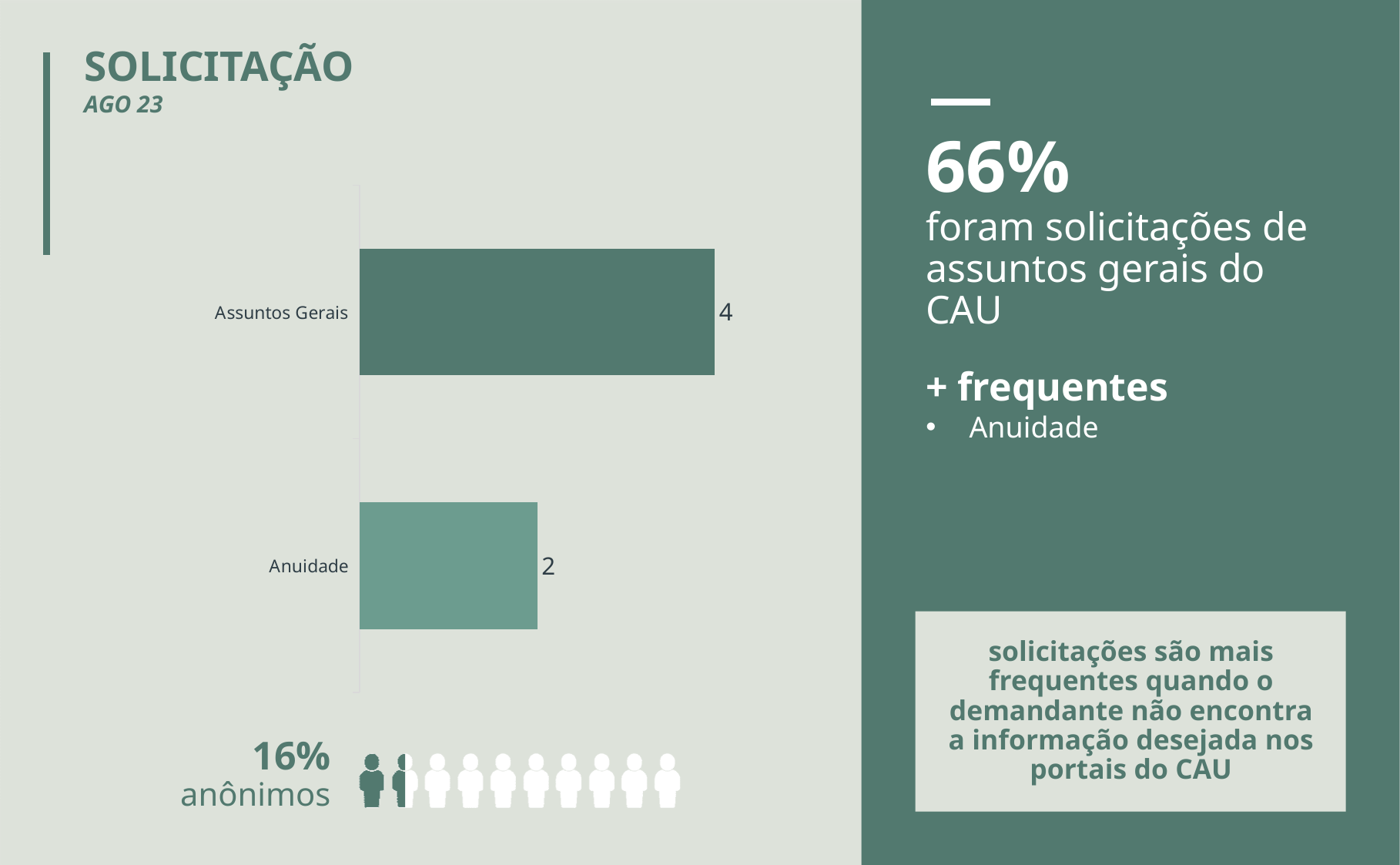
Which is larger, the value for Assuntos Gerais or the value for Anuidade? Assuntos Gerais What is the value for Assuntos Gerais? 4 How many categories are shown in the chart? 2 Which category has the lowest value? Anuidade What is the title shown above the chart on the slide? SOLICITAÇÃO What kind of chart is shown on the slide? bar chart What is the total of the values for Assuntos Gerais and Anuidade? 6 Which month and year does the slide refer to? AGO 23 Which category has the highest value? Assuntos Gerais What is the difference between the values for Assuntos Gerais and Anuidade? 2 What is the value for Anuidade? 2